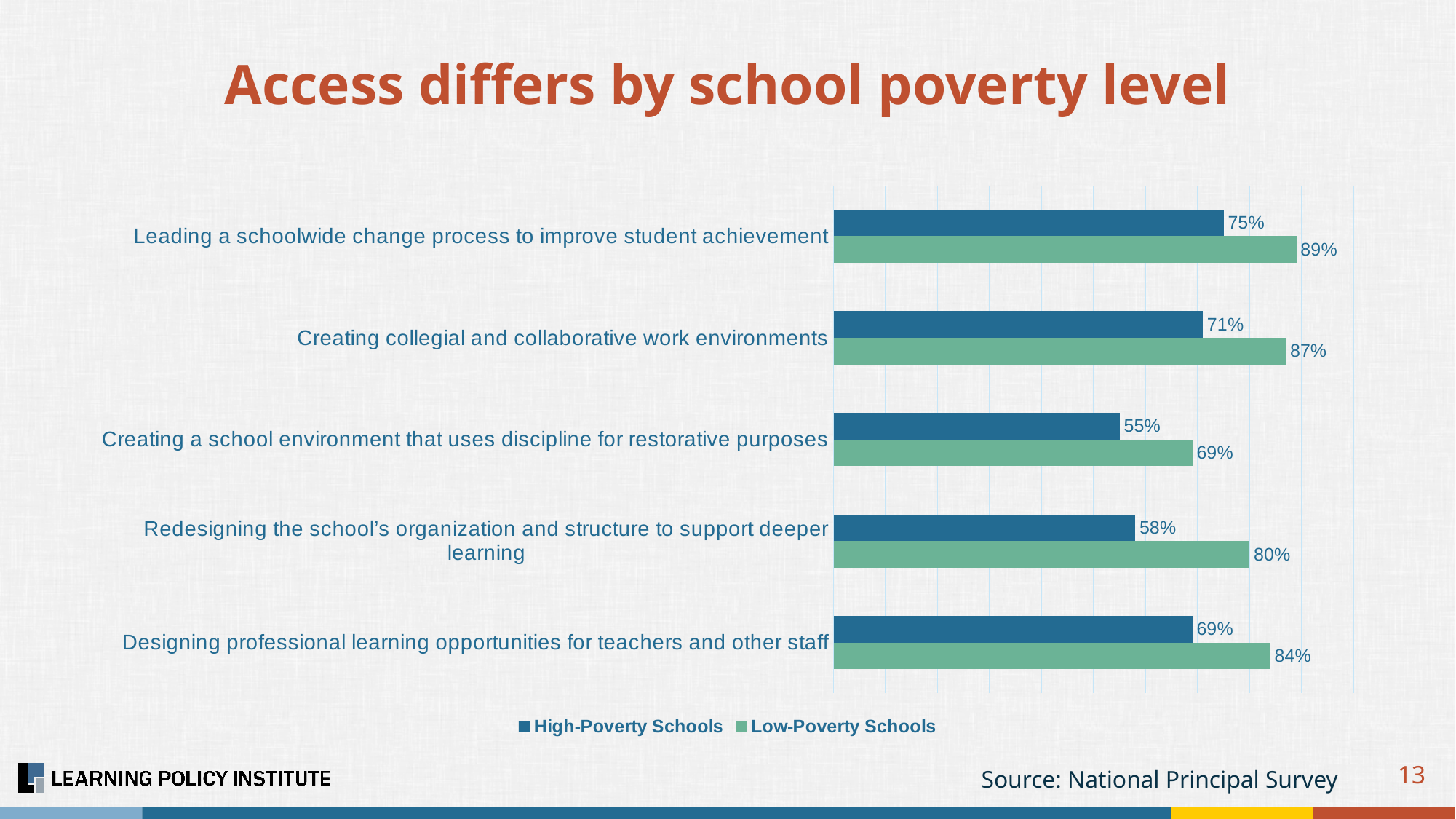
What is the difference between Low-Poverty Schools and High-Poverty Schools for 'Redesigning the school's organization and structure to support deeper learning'? 22 percentage points How many series does the legend list? 2 What is the value for Low-Poverty Schools for 'Creating collegial and collaborative work environments'? 87% What percentage of High-Poverty Schools reported access to 'Leading a schoolwide change process to improve student achievement'? 75% What type of chart is shown on the slide? Bar chart What source is cited for the chart data? National Principal Survey Which category has the lowest value for High-Poverty Schools? Creating a school environment that uses discipline for restorative purposes Which category has the highest value for Low-Poverty Schools? Leading a schoolwide change process to improve student achievement What is the value for High-Poverty Schools for 'Creating a school environment that uses discipline for restorative purposes'? 55% For 'Designing professional learning opportunities for teachers and other staff', which series has the larger value? Low-Poverty Schools What is the title of the slide? Access differs by school poverty level How many categories are shown in the chart? 5